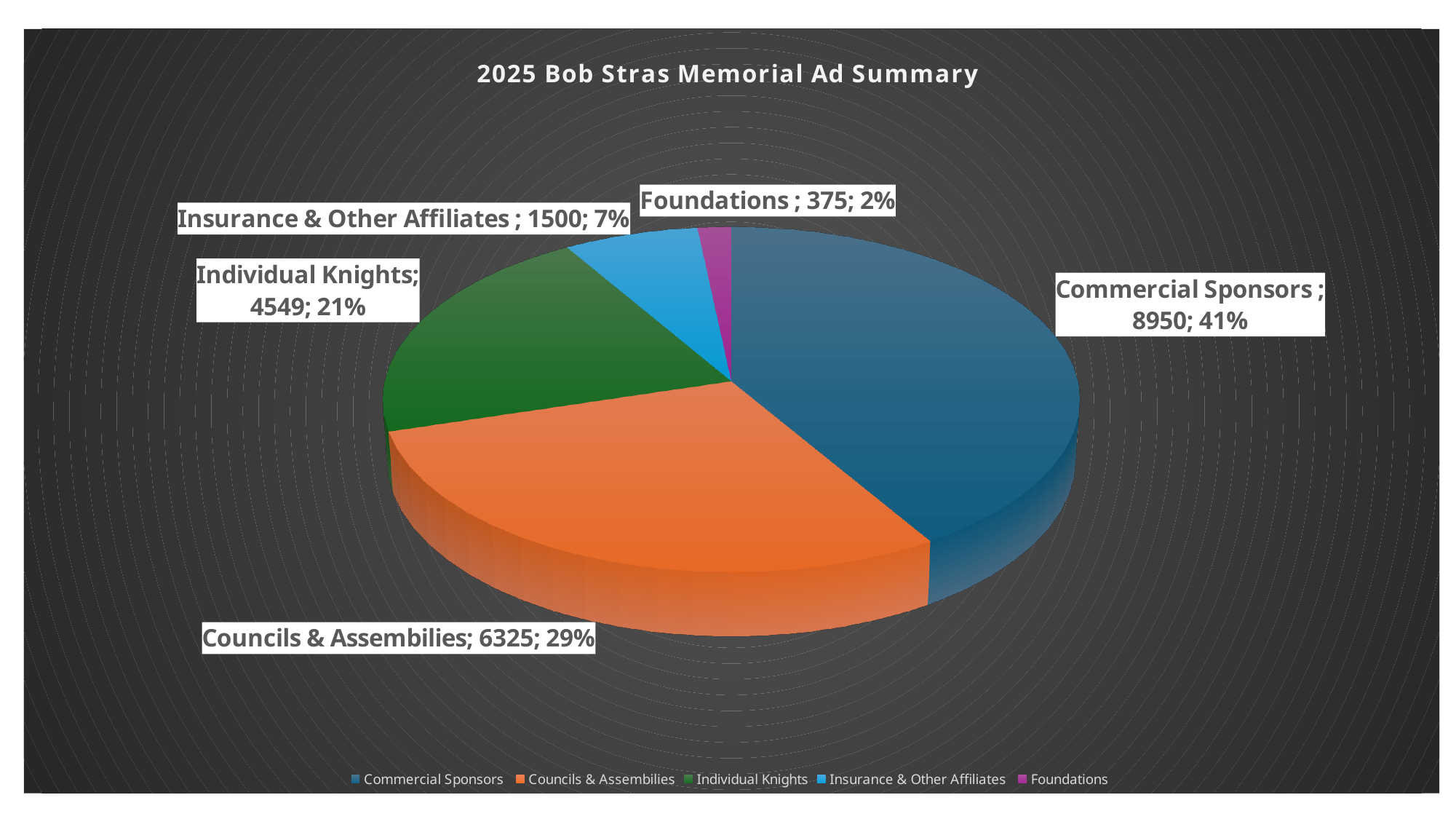
Which is larger, the value for Individual Knights or the value for Insurance & Other Affiliates? Individual Knights What is the value for Commercial Sponsors? 8950 Which category has the smallest slice of the pie? Foundations What is the title of the chart? 2025 Bob Stras Memorial Ad Summary What is the value for Individual Knights? 4549 What share of the pie does Insurance & Other Affiliates represent? 7% What share of the pie does Councils & Assemblies represent? 29% Which category has the largest slice of the pie? Commercial Sponsors What is the difference between the values for Commercial Sponsors and Councils & Assemblies? 2625 What is the value for Foundations? 375 How many categories does the pie chart have? 5 What type of chart is shown on the slide? pie chart